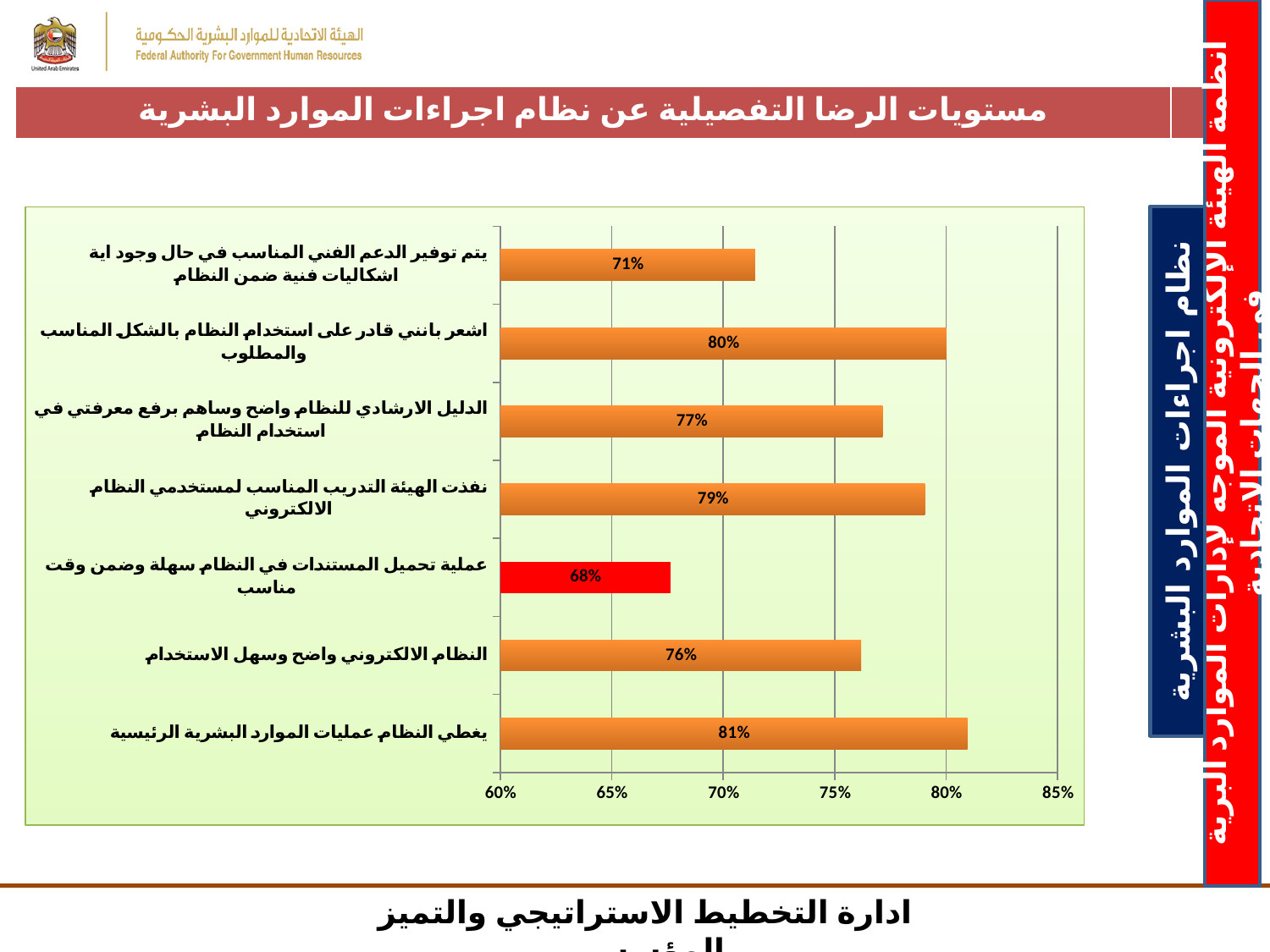
What is the value for the category "النظام الالكتروني واضح وسهل الاستخدام"? 76% What is the value for the category "عملية تحميل المستندات في النظام سهلة وضمن وقت مناسب"? 68% What is the value for the category "نفذت الهيئة التدريب المناسب لمستخدمي النظام الالكتروني"? 79% How many categories are shown in the chart? 7 What is the difference between the highest value (81%) and the lowest value (68%)? 13% Is the value for "يتم توفير الدعم الفني المناسب في حال وجود اية اشكاليات فنية ضمن النظام" greater or less than 75%? less Which bar is coloured red instead of orange? عملية تحميل المستندات في النظام سهلة وضمن وقت مناسب What is the value for the category "يغطي النظام عمليات الموارد البشرية الرئيسية"? 81% Which category has the lowest value? عملية تحميل المستندات في النظام سهلة وضمن وقت مناسب Which is larger: the value for "اشعر بانني قادر على استخدام النظام بالشكل المناسب والمطلوب" or the value for "الدليل الارشادي للنظام واضح وساهم برفع معرفتي في استخدام النظام"? اشعر بانني قادر على استخدام النظام بالشكل المناسب والمطلوب What kind of chart is shown on the slide? bar chart Which category has the highest value? يغطي النظام عمليات الموارد البشرية الرئيسية